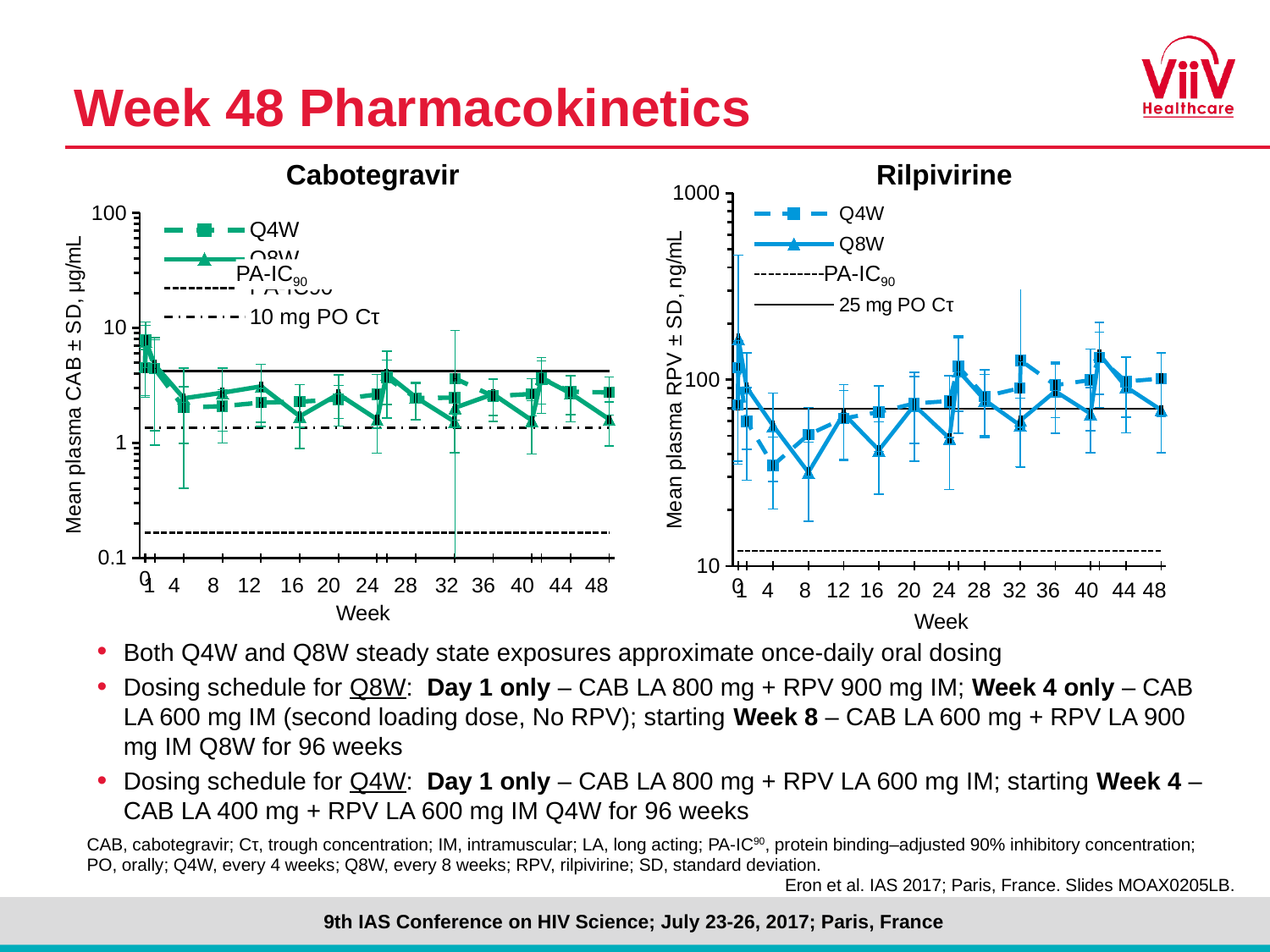
In the Cabotegravir chart, does the Q8W value rise or fall between week 1 and week 4? fall In the Cabotegravir chart, is the PA-IC90 reference line above or below 1 µg/mL? below What kind of chart is the Cabotegravir chart? Line chart Which reference line in the Rilpivirine legend is labelled with an oral dose? 25 mg PO Cτ What is the y-axis label of the Rilpivirine chart? Mean plasma RPV ± SD, ng/mL In the Cabotegravir chart, is the Q8W value at week 48 greater or less than 10? less In the Cabotegravir chart, is the Q4W value at week 48 greater or less than 1? greater How many entries does the legend of the Rilpivirine chart list? 4 How many entries does the legend of the Cabotegravir chart list? 4 In the Rilpivirine chart, does the Q8W value rise or fall between week 1 and week 8? fall